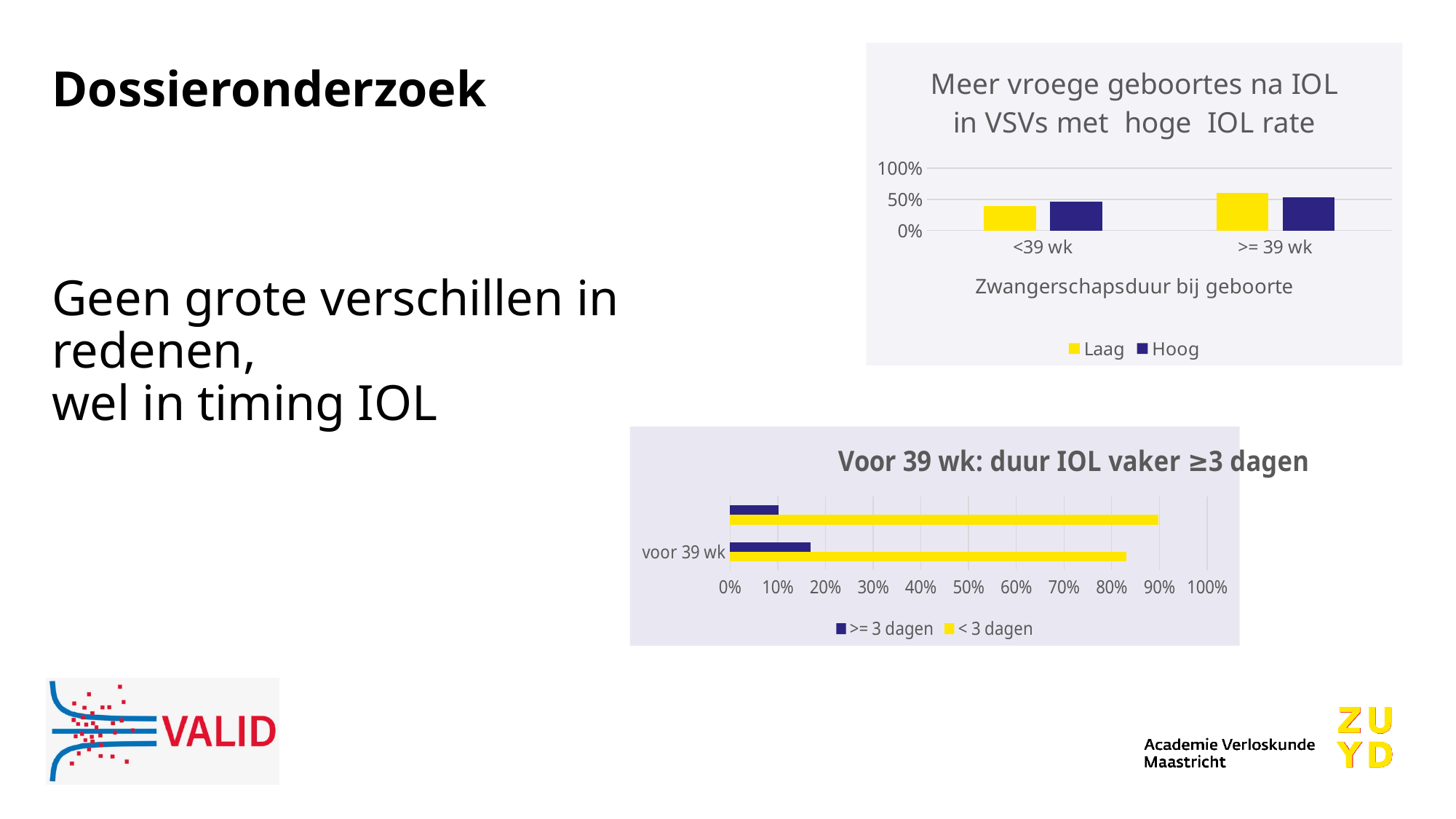
In the chart titled 'Meer vroege geboortes na IOL in VSVs met hoge IOL rate', how many categories are shown on the x axis? 2 In the chart titled 'Meer vroege geboortes na IOL in VSVs met hoge IOL rate', is the value for Laag at >= 39 wk greater or less than 50%? greater In the chart titled 'Meer vroege geboortes na IOL in VSVs met hoge IOL rate', which is larger at <39 wk: Laag or Hoog? Hoog In the chart titled 'Voor 39 wk: duur IOL vaker ≥3 dagen', what kind of chart is shown? bar chart In the chart titled 'Meer vroege geboortes na IOL in VSVs met hoge IOL rate', what is the x-axis title? Zwangerschapsduur bij geboorte In the chart titled 'Meer vroege geboortes na IOL in VSVs met hoge IOL rate', is the value for Laag at <39 wk greater or less than 50%? less In the chart titled 'Meer vroege geboortes na IOL in VSVs met hoge IOL rate', how many series does the legend list? 2 In the chart titled 'Voor 39 wk: duur IOL vaker ≥3 dagen', is the value for '< 3 dagen' at 'voor 39 wk' greater or less than 80%? greater In the chart titled 'Voor 39 wk: duur IOL vaker ≥3 dagen', which series is shown in yellow? < 3 dagen In the chart titled 'Voor 39 wk: duur IOL vaker ≥3 dagen', how many series does the legend list? 2 In the chart titled 'Meer vroege geboortes na IOL in VSVs met hoge IOL rate', what kind of chart is shown? bar chart